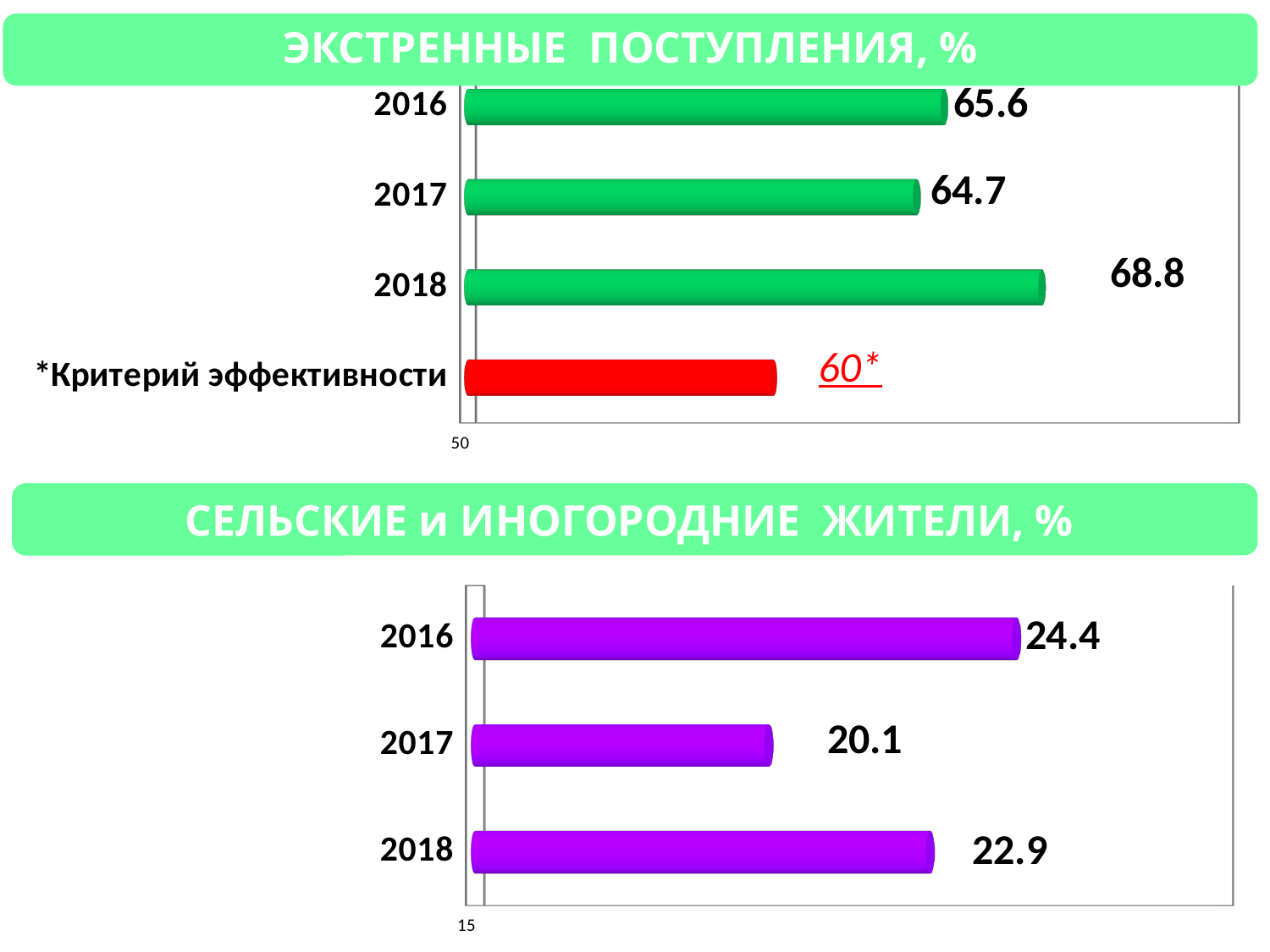
In the chart titled "ЭКСТРЕННЫЕ ПОСТУПЛЕНИЯ, %", what is the value for 2018? 68.8 In the chart titled "ЭКСТРЕННЫЕ ПОСТУПЛЕНИЯ, %", what is the difference between the 2018 value and the 2016 value? 3.2 In the chart titled "СЕЛЬСКИЕ и ИНОГОРОДНИЕ ЖИТЕЛИ, %", what is the value for 2017? 20.1 In the chart titled "ЭКСТРЕННЫЕ ПОСТУПЛЕНИЯ, %", what value is shown for "*Критерий эффективности"? 60* In the chart titled "СЕЛЬСКИЕ и ИНОГОРОДНИЕ ЖИТЕЛИ, %", which year has the lowest value? 2017 In the chart titled "ЭКСТРЕННЫЕ ПОСТУПЛЕНИЯ, %", which year has the highest value? 2018 In the chart titled "СЕЛЬСКИЕ и ИНОГОРОДНИЕ ЖИТЕЛИ, %", what is the value for 2016? 24.4 In the chart titled "ЭКСТРЕННЫЕ ПОСТУПЛЕНИЯ, %", how many bars are plotted? 4 In the chart titled "ЭКСТРЕННЫЕ ПОСТУПЛЕНИЯ, %", which year has the lowest value? 2017 In the chart titled "СЕЛЬСКИЕ и ИНОГОРОДНИЕ ЖИТЕЛИ, %", what is the difference between the 2016 value and the 2018 value? 1.5 What type of chart is the chart titled "СЕЛЬСКИЕ и ИНОГОРОДНИЕ ЖИТЕЛИ, %"? Bar chart In the chart titled "ЭКСТРЕННЫЕ ПОСТУПЛЕНИЯ, %", what is the value for 2017? 64.7